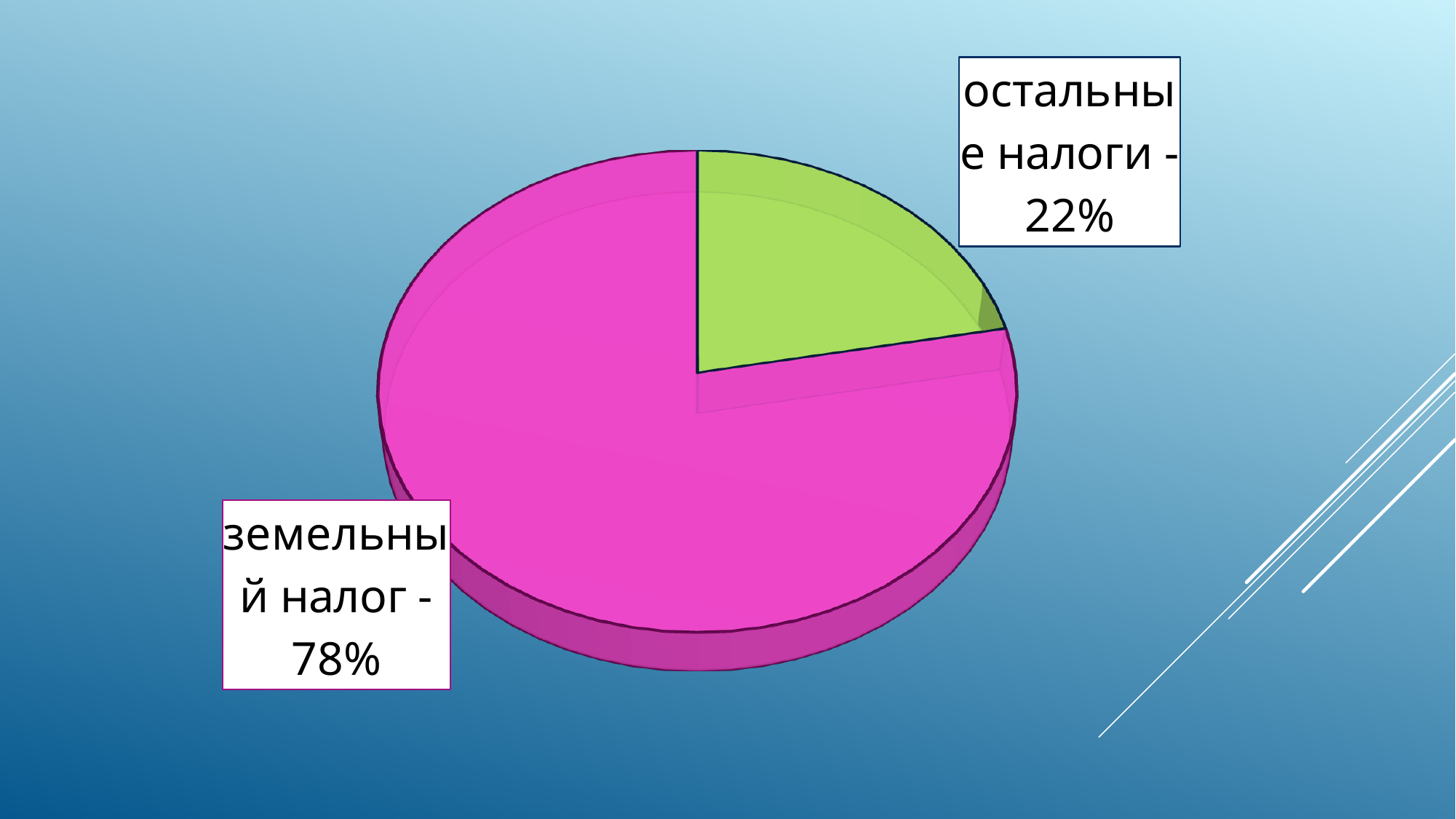
What is the difference in percentage points between земельный налог and остальные налоги? 56 Which slice of the pie is the smallest? остальные налоги What colour is the slice for земельный налог? pink (magenta) Which is larger, the share for земельный налог or the share for остальные налоги? земельный налог Is the share for земельный налог greater or less than 50%? greater What kind of chart is shown on the slide? pie chart Which slice of the pie is the largest? земельный налог What colour is the slice for остальные налоги? green Is the share for остальные налоги greater or less than 25%? less What share of the pie does остальные налоги take? 22% What share of the pie does земельный налог take? 78% How many slices does the pie chart have? 2